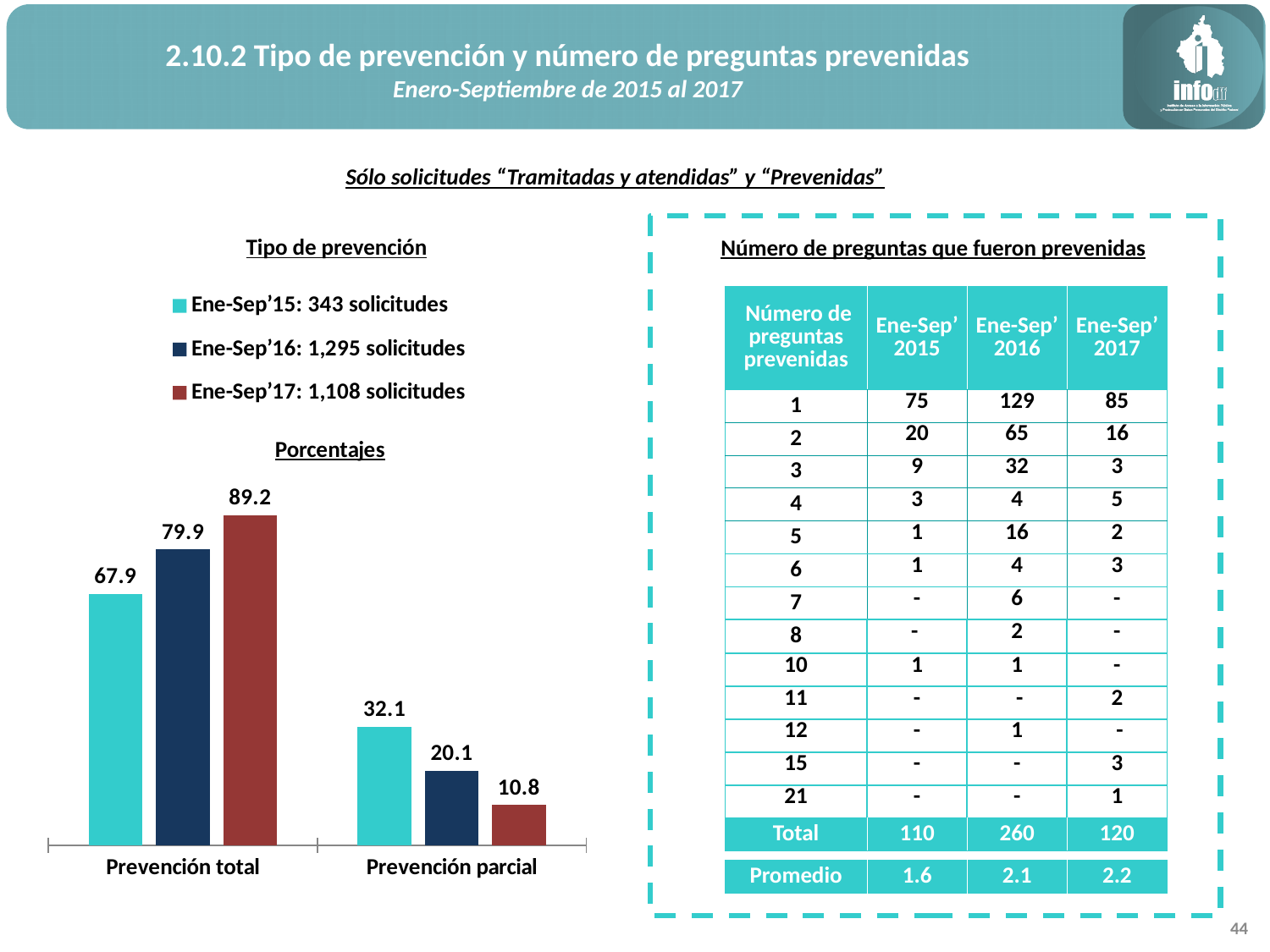
In the "Tipo de prevención" chart, which series has the lowest value for Prevención parcial? Ene-Sep'17 In the "Tipo de prevención" chart, how many solicitudes does the legend give for Ene-Sep'16? 1,295 solicitudes In the "Tipo de prevención" chart, what is the difference between the Ene-Sep'17 and Ene-Sep'15 values for Prevención total? 21.3 In the "Tipo de prevención" chart, which is larger: the Ene-Sep'16 value for Prevención total or the Ene-Sep'16 value for Prevención parcial? Prevención total In the "Tipo de prevención" chart, what is the value for Ene-Sep'17 in Prevención parcial? 10.8 How many categories are shown on the x axis of the "Tipo de prevención" chart? 2 What type of chart is shown under "Tipo de prevención"? bar chart In the "Tipo de prevención" chart, what is the difference between the Ene-Sep'15 and Ene-Sep'16 values for Prevención parcial? 12 In the "Tipo de prevención" chart, what is the value for Ene-Sep'16 in Prevención total? 79.9 In the "Tipo de prevención" chart, what is the value for Ene-Sep'15 in Prevención total? 67.9 How many series does the legend of the "Tipo de prevención" chart list? 3 In the "Tipo de prevención" chart, which series has the highest value for Prevención total? Ene-Sep'17